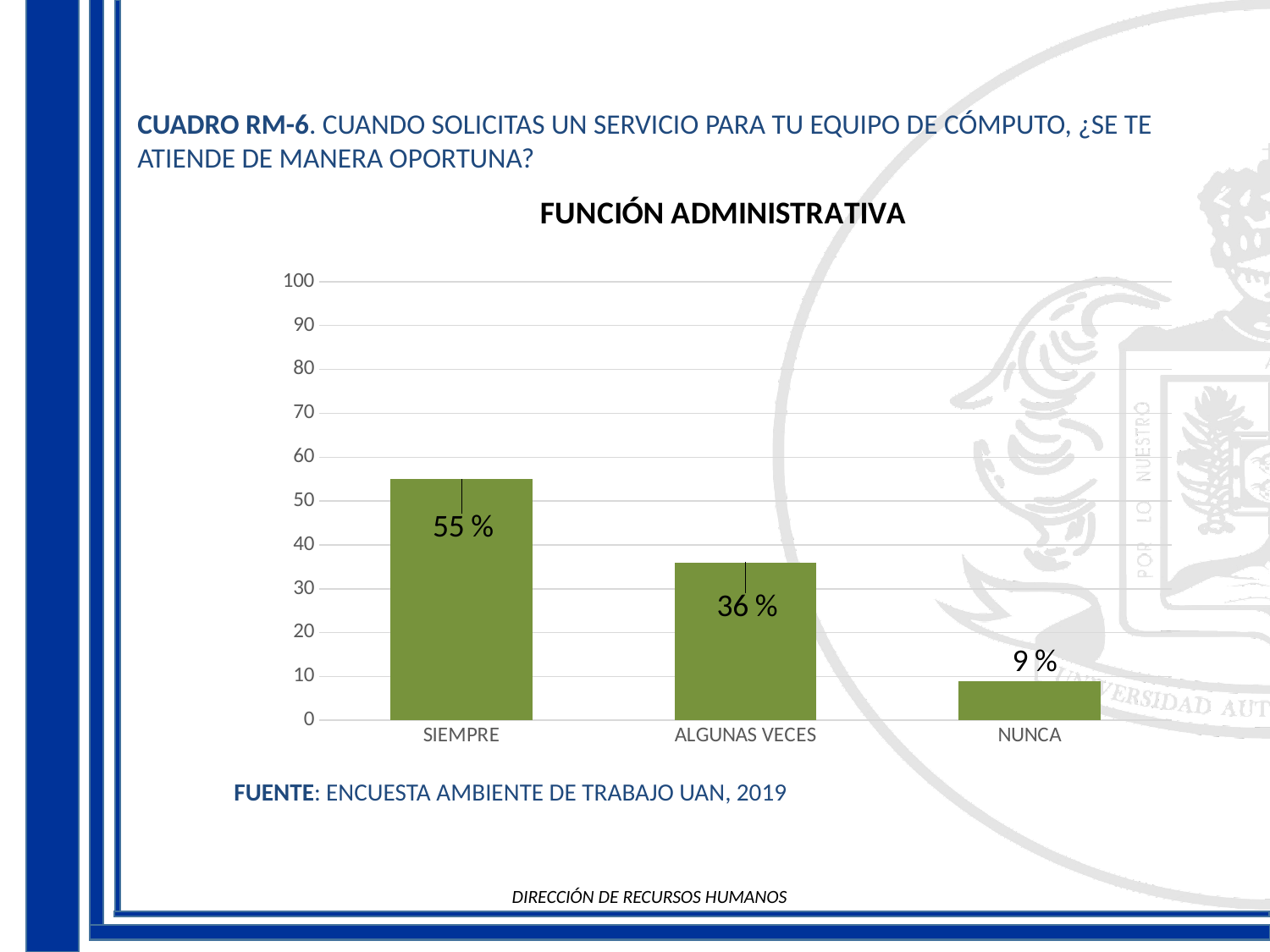
Which category has the highest value? SIEMPRE What kind of chart is shown? bar chart What is the value for ALGUNAS VECES? 36 % Is the value for SIEMPRE greater or less than 50? greater What is the difference between the values for SIEMPRE and ALGUNAS VECES? 19 % Which category has the lowest value? NUNCA What is the value for SIEMPRE? 55 % What is the difference between the values for ALGUNAS VECES and NUNCA? 27 % Which is larger, the value for ALGUNAS VECES or the value for NUNCA? ALGUNAS VECES What is the value for NUNCA? 9 % What is the title of the chart? FUNCIÓN ADMINISTRATIVA How many categories are shown on the x axis? 3